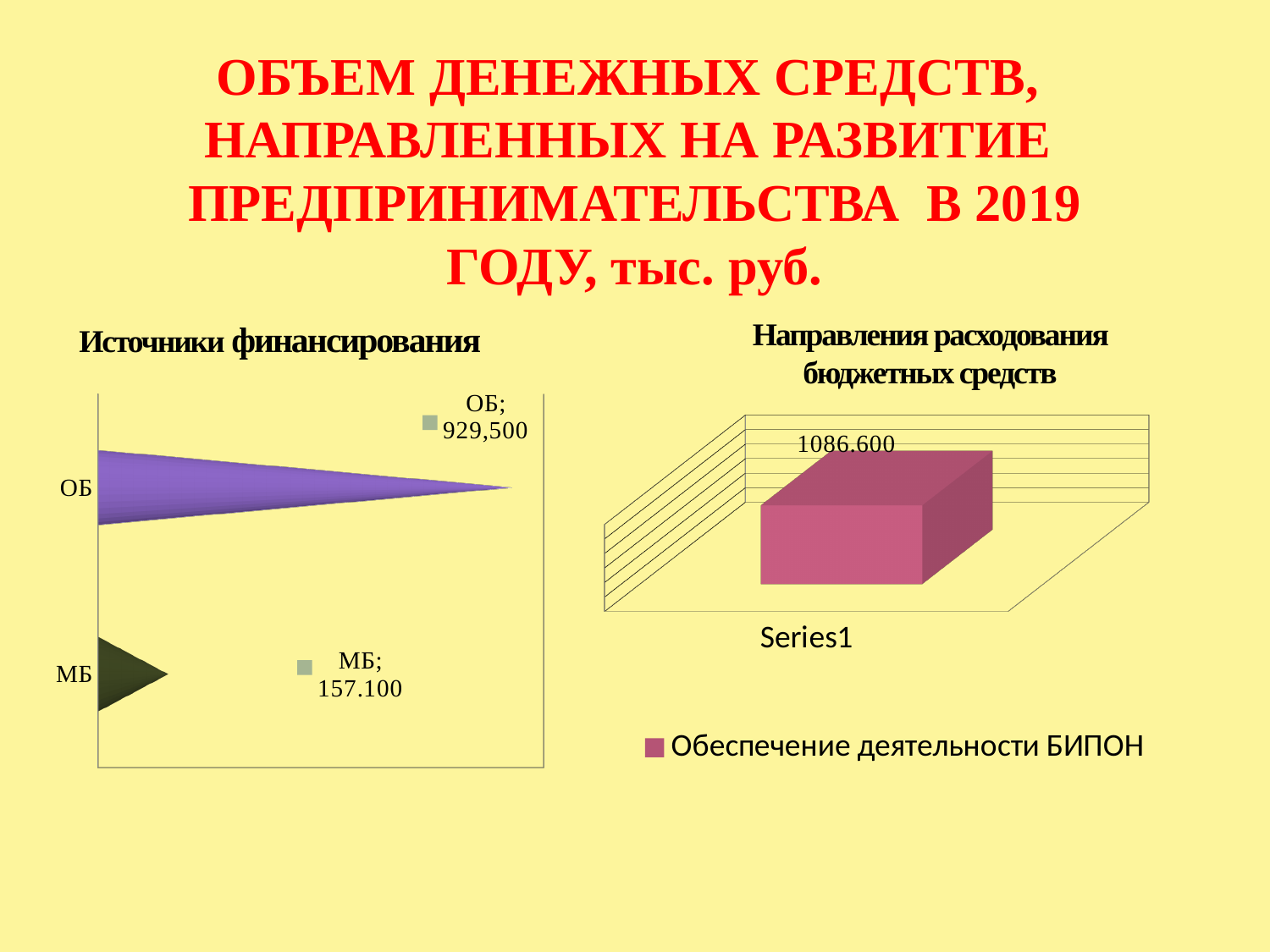
What is the legend entry in the 'Направления расходования бюджетных средств' chart? Обеспечение деятельности БИПОН In the 'Источники финансирования' chart, which category has the highest value? ОБ How many categories are shown in the 'Источники финансирования' chart? 2 In the 'Направления расходования бюджетных средств' chart, what is the value of the bar? 1086.600 What is the title of the chart on the left side of the slide? Источники финансирования How many series does the legend of the 'Направления расходования бюджетных средств' chart list? 1 What kind of chart is the 'Источники финансирования' chart? Bar chart How many bars are plotted in the 'Направления расходования бюджетных средств' chart? 1 In the 'Источники финансирования' chart, what is the value for МБ? 157.100 In the 'Источники финансирования' chart, which category has the lowest value? МБ In the 'Источники финансирования' chart, which is larger, ОБ or МБ? ОБ In the 'Источники финансирования' chart, what is the value for ОБ? 929,500